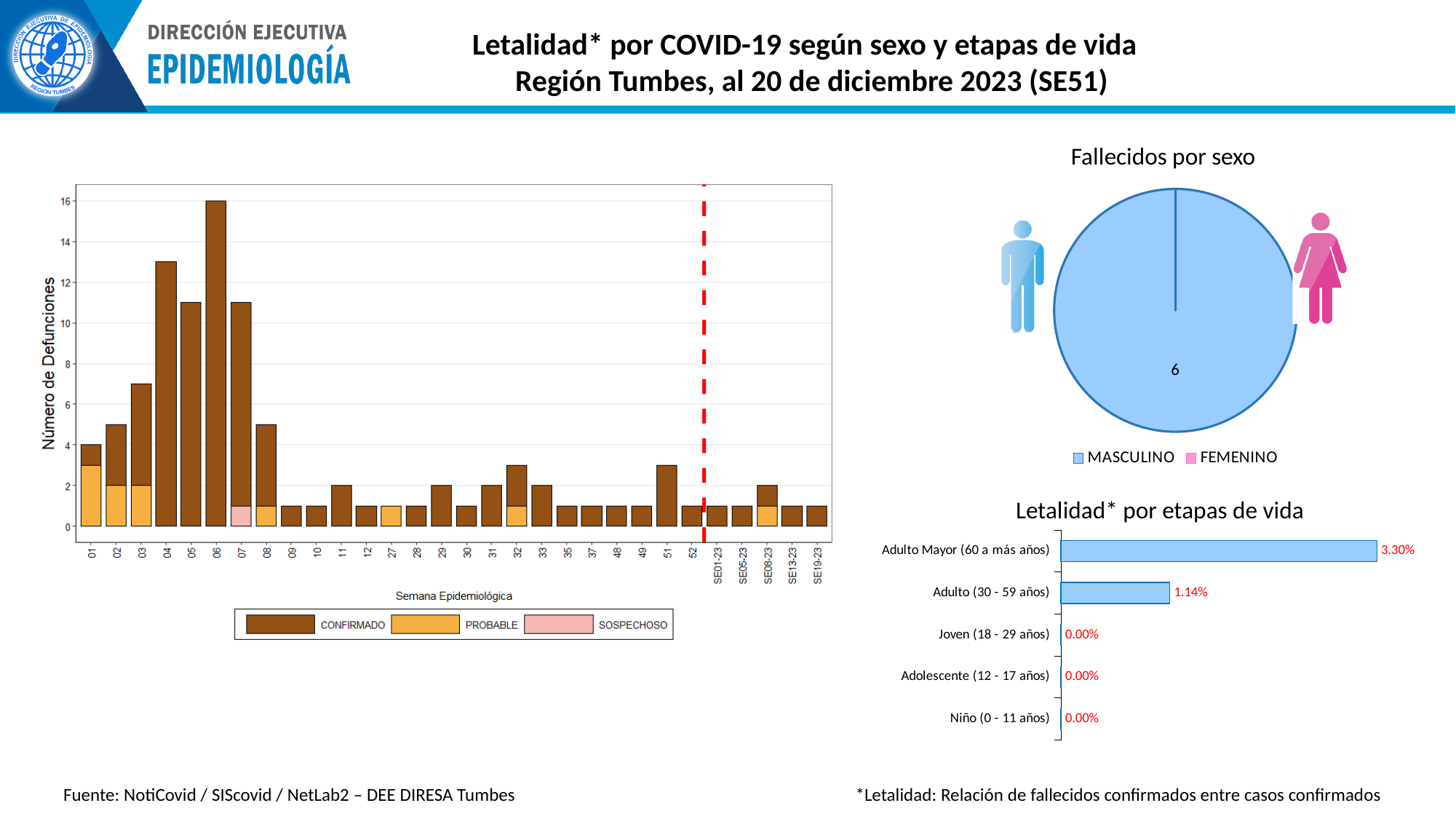
In the 'Letalidad* por etapas de vida' chart, which age group has the highest value? Adulto Mayor (60 a más años) In the 'Letalidad* por etapas de vida' chart, what is the value for Adulto (30 - 59 años)? 1.14% In the 'Letalidad* por etapas de vida' chart, what is the value for Joven (18 - 29 años)? 0.00% In the 'Letalidad* por etapas de vida' chart, how many age groups are shown? 5 In the 'Letalidad* por etapas de vida' chart, what is the value for Adulto Mayor (60 a más años)? 3.30% In the left chart of Número de Defunciones by Semana Epidemiológica, what is the number of deaths in week 06? 16 In the 'Letalidad* por etapas de vida' chart, what is the difference between the values for Adulto Mayor (60 a más años) and Adulto (30 - 59 años)? 2.16% In the left chart of Número de Defunciones by Semana Epidemiológica, is the value for week 04 greater or less than 12? greater In the 'Fallecidos por sexo' pie chart, what value is shown for MASCULINO? 6 In the 'Fallecidos por sexo' pie chart, how many categories does the legend list? 2 In the left chart of Número de Defunciones by Semana Epidemiológica, which week has the highest number of deaths? 06 In the left chart of Número de Defunciones by Semana Epidemiológica, how many series does the legend list? 3